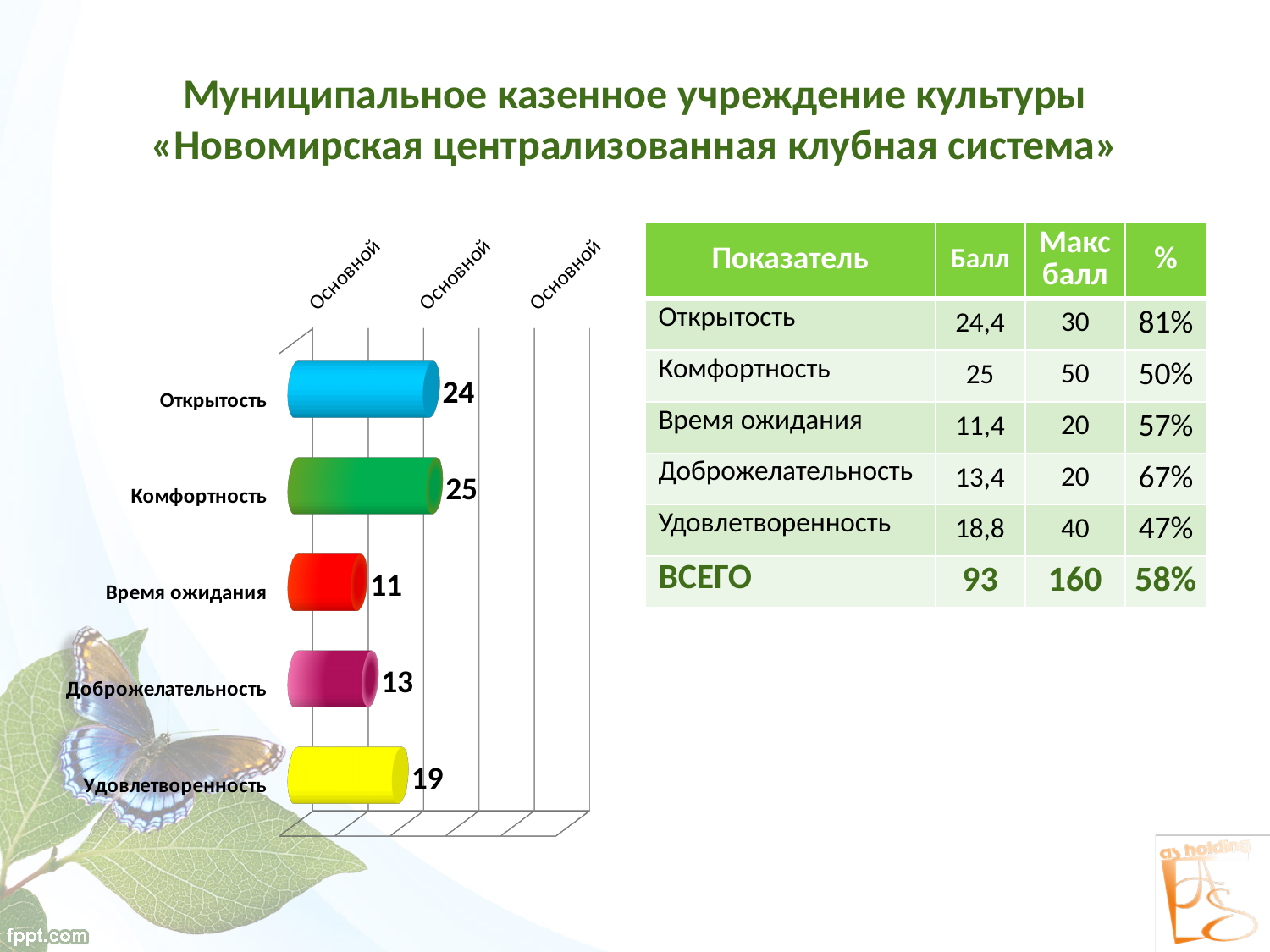
What value is shown for Комфортность in the bar chart? 25 What value is shown for Доброжелательность in the bar chart? 13 What is the difference between the values for Комфортность and Время ожидания in the bar chart? 14 What value is shown for Открытость in the bar chart? 24 Which category has the lowest value in the bar chart? Время ожидания How many categories are shown in the bar chart? 5 What kind of chart is shown on the slide? Bar chart Which category has the highest value in the bar chart? Комфортность What colour is the bar for Удовлетворенность in the bar chart? Yellow What value is shown for Время ожидания in the bar chart? 11 What value is shown for Удовлетворенность in the bar chart? 19 Which is larger in the bar chart, the value for Удовлетворенность or the value for Доброжелательность? Удовлетворенность